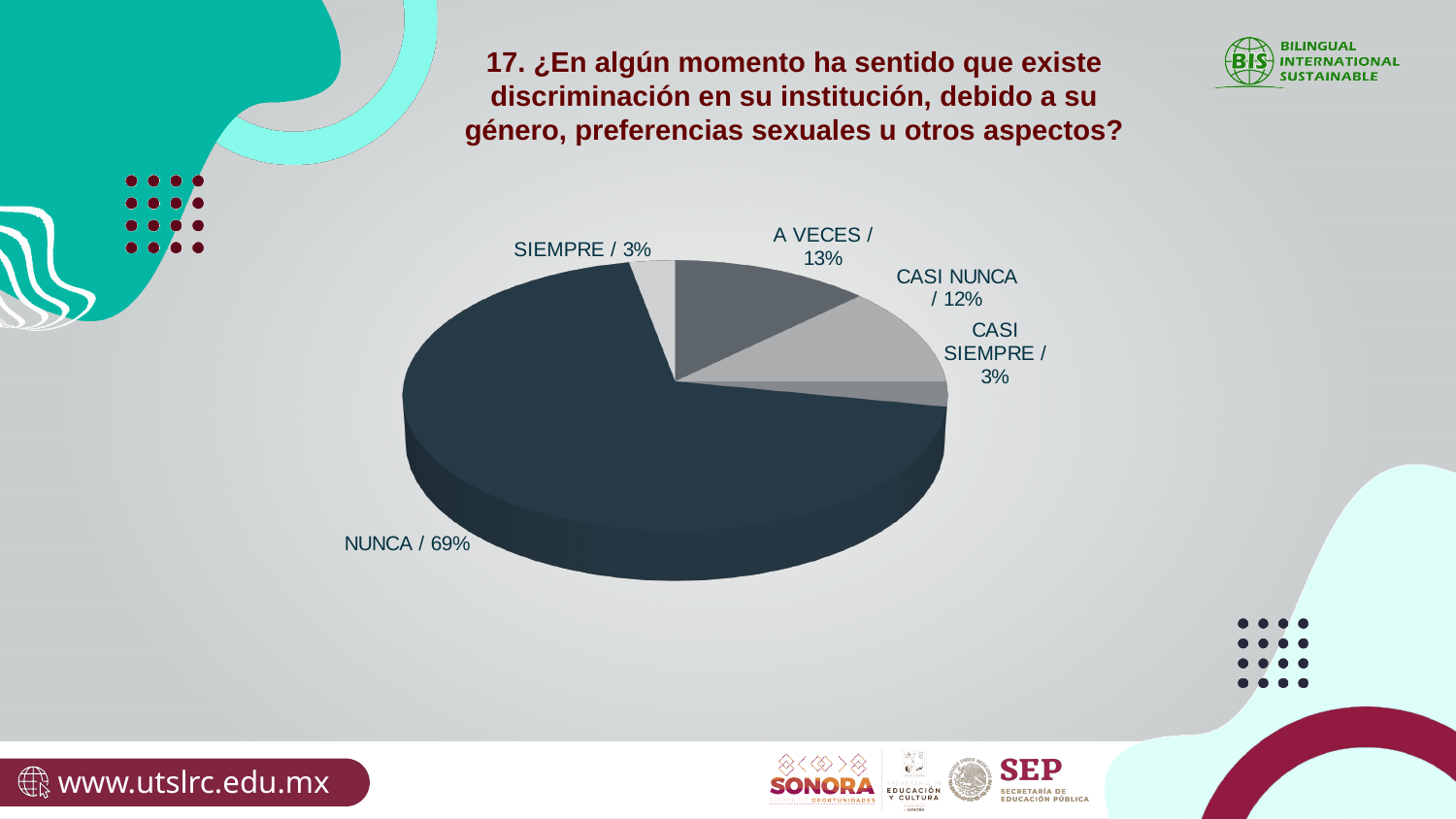
Which is larger, the share for A VECES or the share for CASI NUNCA? A VECES What percentage of the pie corresponds to SIEMPRE? 3% How many slices does the pie chart have? 5 What percentage of the pie corresponds to NUNCA? 69% What is the combined share of SIEMPRE and CASI SIEMPRE? 6% What kind of chart is shown on the slide? pie chart What percentage of the pie corresponds to A VECES? 13% Which category has the largest share of the pie? NUNCA What percentage of the pie corresponds to CASI SIEMPRE? 3% What is the difference in percentage points between NUNCA and A VECES? 56 What is the number of the survey question shown in the slide title? 17 What percentage of the pie corresponds to CASI NUNCA? 12%